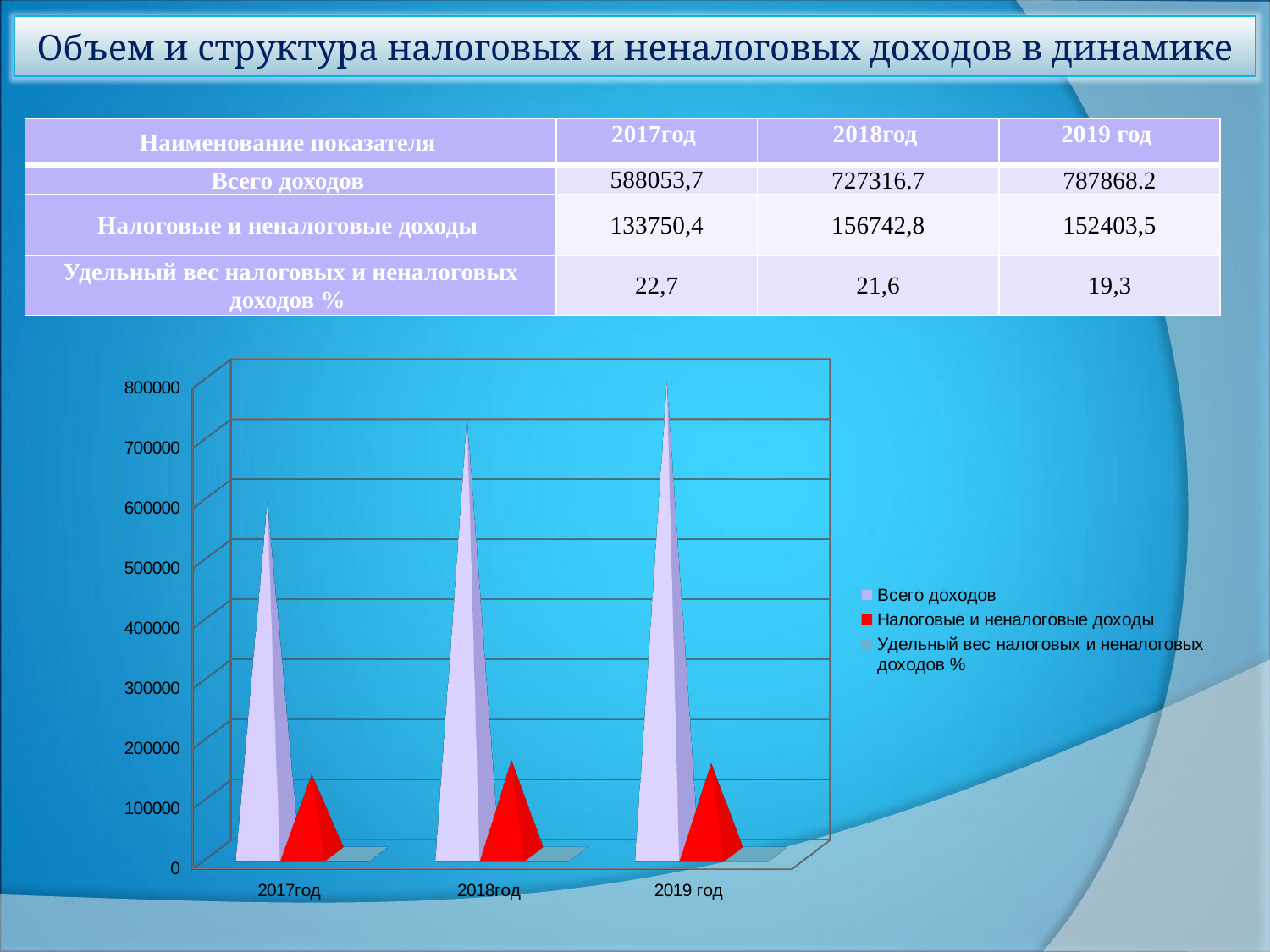
According to the table, what is the Удельный вес налоговых и неналоговых доходов % for 2019 год? 19,3 Which year has the lowest value for Всего доходов? 2017год Is the value for Всего доходов in 2018год greater or less than 700000? greater How many series does the chart legend list? 3 What kind of chart is shown on the slide? bar chart Is the value for Всего доходов in 2017год greater or less than 500000? greater Do the values for Всего доходов rise or fall from 2017год to 2019 год? rise Is the value for Налоговые и неналоговые доходы in 2018год greater or less than 200000? less Which year has the highest value for Всего доходов? 2019 год According to the table, what is the value of Налоговые и неналоговые доходы for 2017год? 133750,4 How many year categories are shown on the x axis of the chart? 3 Which series is shown in red in the chart? Налоговые и неналоговые доходы